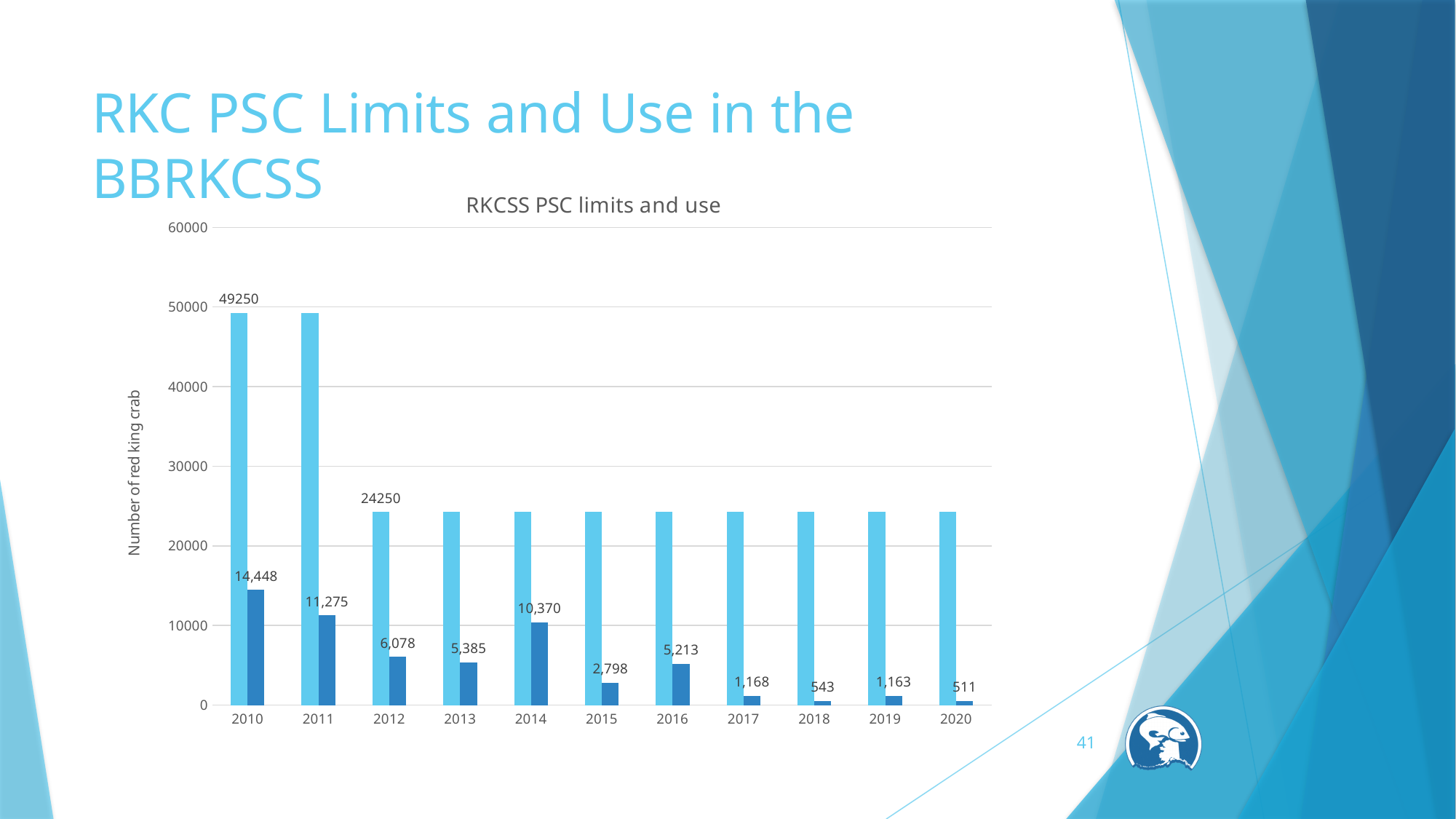
What is the value of the dark blue bar for 2018? 543 What is the value of the light blue bar for 2010? 49250 Which year has the highest dark blue bar? 2010 How many years are shown on the x axis? 11 Do the dark blue bar values rise or fall from 2010 to 2013? fall What is the difference between the dark blue bar values for 2010 and 2011? 3,173 Which year has a larger dark blue bar, 2014 or 2016? 2014 What is the label on the vertical axis of the chart? Number of red king crab What is the value of the dark blue bar for 2010? 14,448 Which year has the lowest dark blue bar? 2020 Is the value of the light blue bar for 2015 greater or less than 20000? greater What is the value of the light blue bar for 2012? 24250